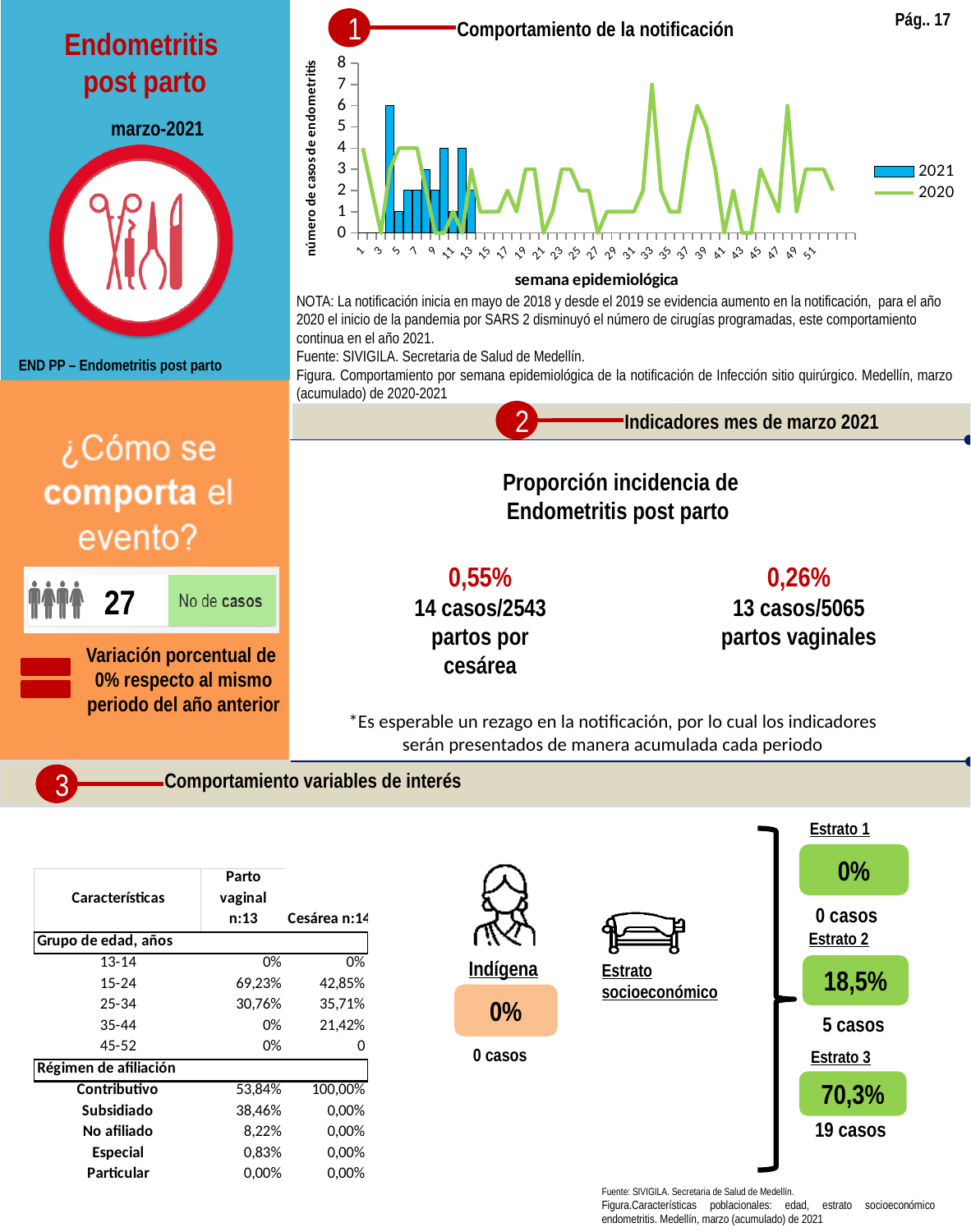
What is the maximum value shown on the y axis of the 'Comportamiento de la notificación' chart? 8 In the 'Comportamiento de la notificación' chart, which series is drawn as bars? 2021 In the 'Comportamiento de la notificación' chart, what is the highest value reached by the 2020 line? 7 What kind of chart is 'Comportamiento de la notificación'? A combined bar and line chart Which two years are listed in the legend of the 'Comportamiento de la notificación' chart? 2021 and 2020 How many series does the legend of the 'Comportamiento de la notificación' chart list? 2 In the 'Comportamiento de la notificación' chart, how many cases does the tallest 2021 bar reach? 6 In the 'Comportamiento de la notificación' chart, is the 2020 line value at week 33 greater or less than 6? greater In the 'Comportamiento de la notificación' chart, at which epidemiological week is the tallest 2021 bar? Week 4